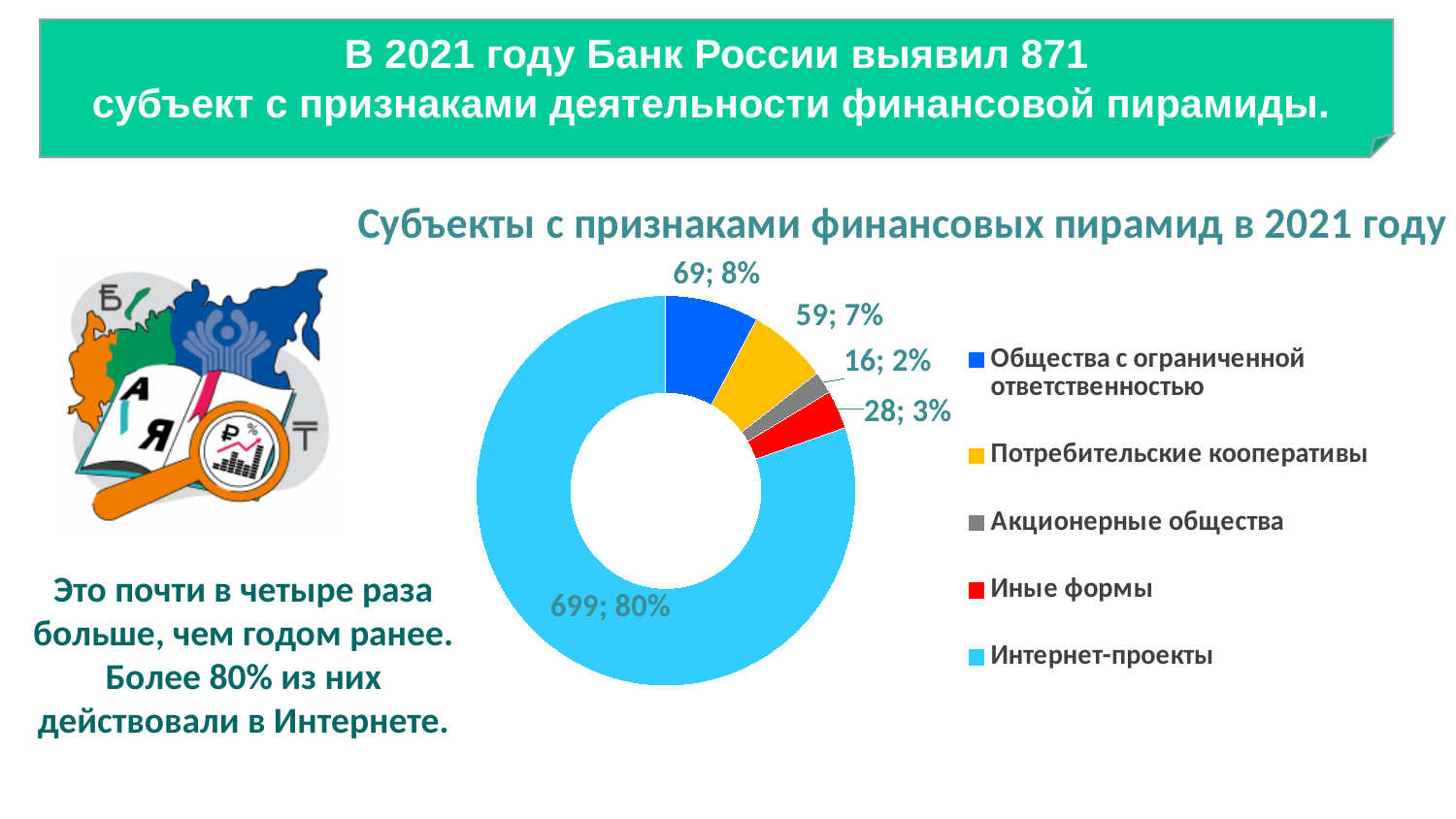
Which category has the smallest value? Акционерные общества What is the value for Потребительские кооперативы? 59 What is the value for Общества с ограниченной ответственностью? 69 What share of the pie does Иные формы take? 3% What is the value for Интернет-проекты? 699 What is the difference between the values for Общества с ограниченной ответственностью and Потребительские кооперативы? 10 What kind of chart is shown on the slide? doughnut (pie) chart What is the value for Акционерные общества? 16 What is the title of the chart? Субъекты с признаками финансовых пирамид в 2021 году How many categories does the chart show? 5 What share of the pie does Интернет-проекты take? 80% Which category has the largest value? Интернет-проекты